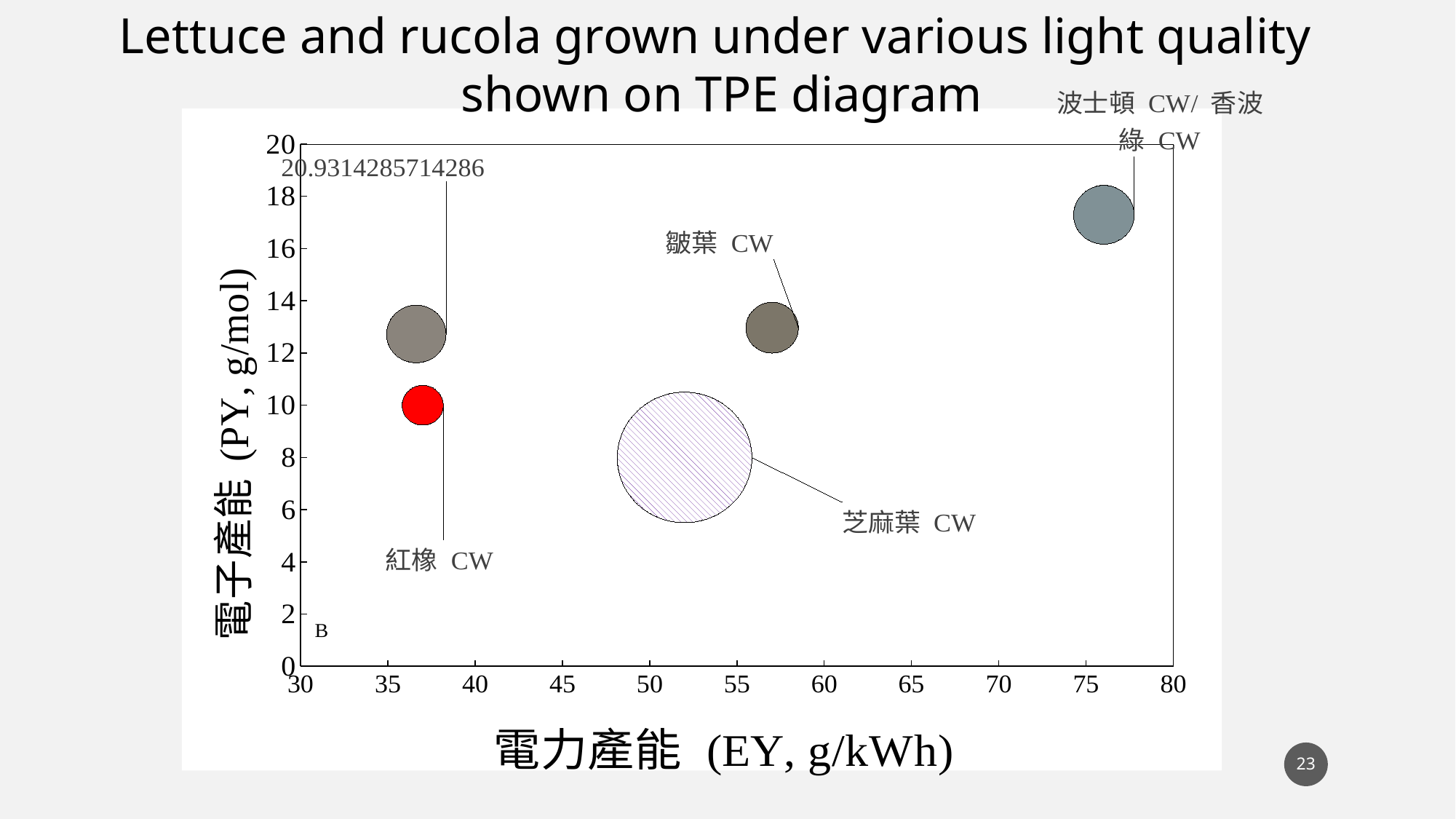
What is the title of the slide's chart? Lettuce and rucola grown under various light quality shown on TPE diagram What is the label of the x axis? 電力產能 (EY, g/kWh) Is the 電子產能 (PY) value for 波士頓 CW/香波綠 CW greater or less than 16? greater What kind of chart is shown on the slide? bubble chart Which has the larger 電力產能 (EY) value, 皺葉 CW or 紅橡 CW? 皺葉 CW Which labelled bubble has the highest 電力產能 (EY) value? 波士頓 CW/香波綠 CW Which labelled bubble has the lowest 電子產能 (PY) value? 芝麻葉 CW How many bubbles are plotted on the chart? 5 Which labelled bubble has the highest 電子產能 (PY) value? 波士頓 CW/香波綠 CW Is the 電力產能 (EY) value for 皺葉 CW greater or less than 50? greater Is the 電力產能 (EY) value for 芝麻葉 CW greater or less than 45? greater